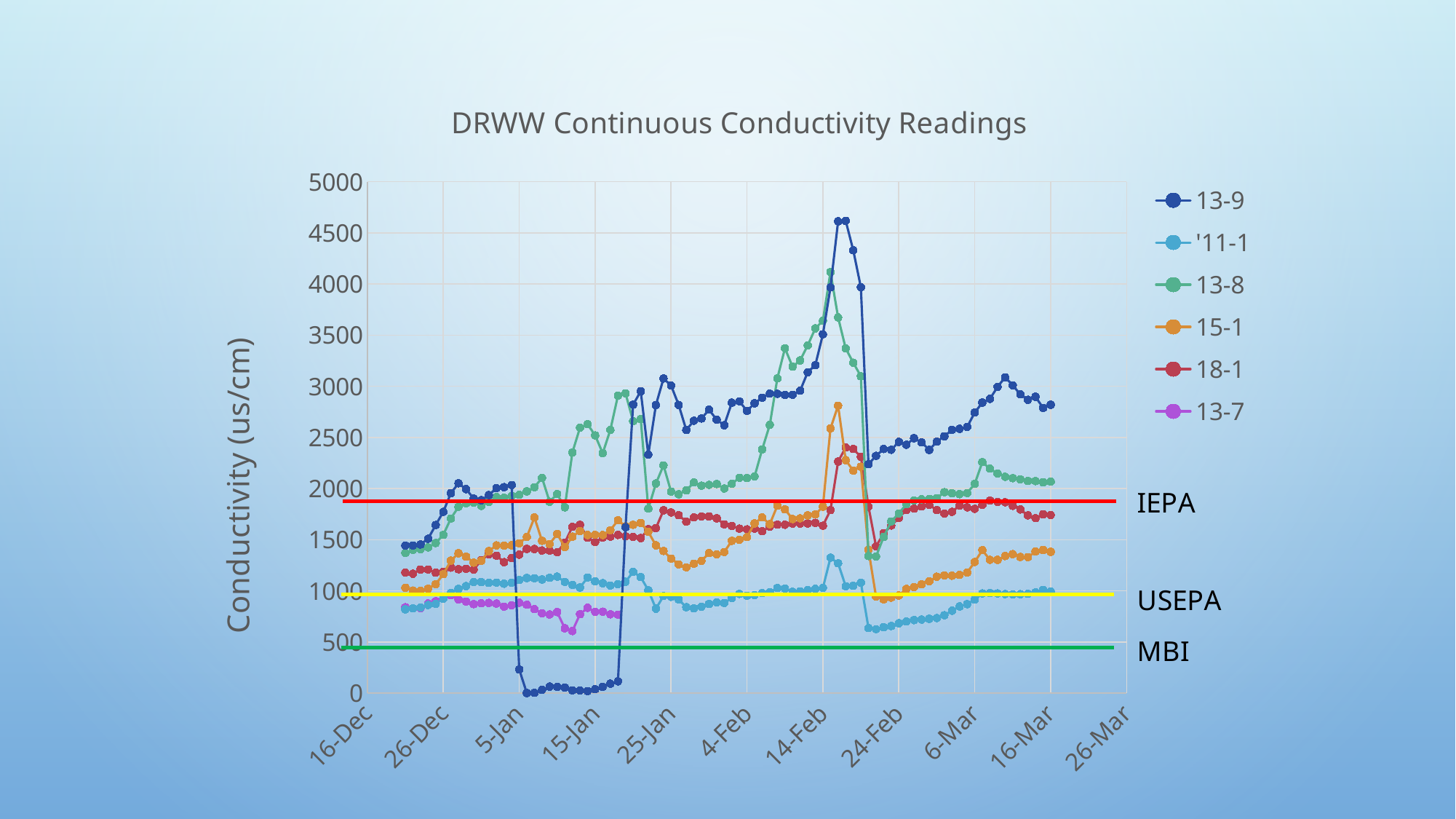
Is the IEPA reference line greater or less than 1500? greater What is the label on the vertical axis? Conductivity (us/cm) Which series reaches the highest peak on the chart? 13-9 Is the peak value of series 13-8 greater or less than 3500? greater What kind of chart is shown on the slide? line chart How many series does the legend list? 6 Is the MBI reference line greater or less than 500? less What is the title of the chart? DRWW Continuous Conductivity Readings Which series drops to near 0 in early January? 13-9 Do the values of series 13-9 rise or fall between 24-Feb and 6-Mar? rise